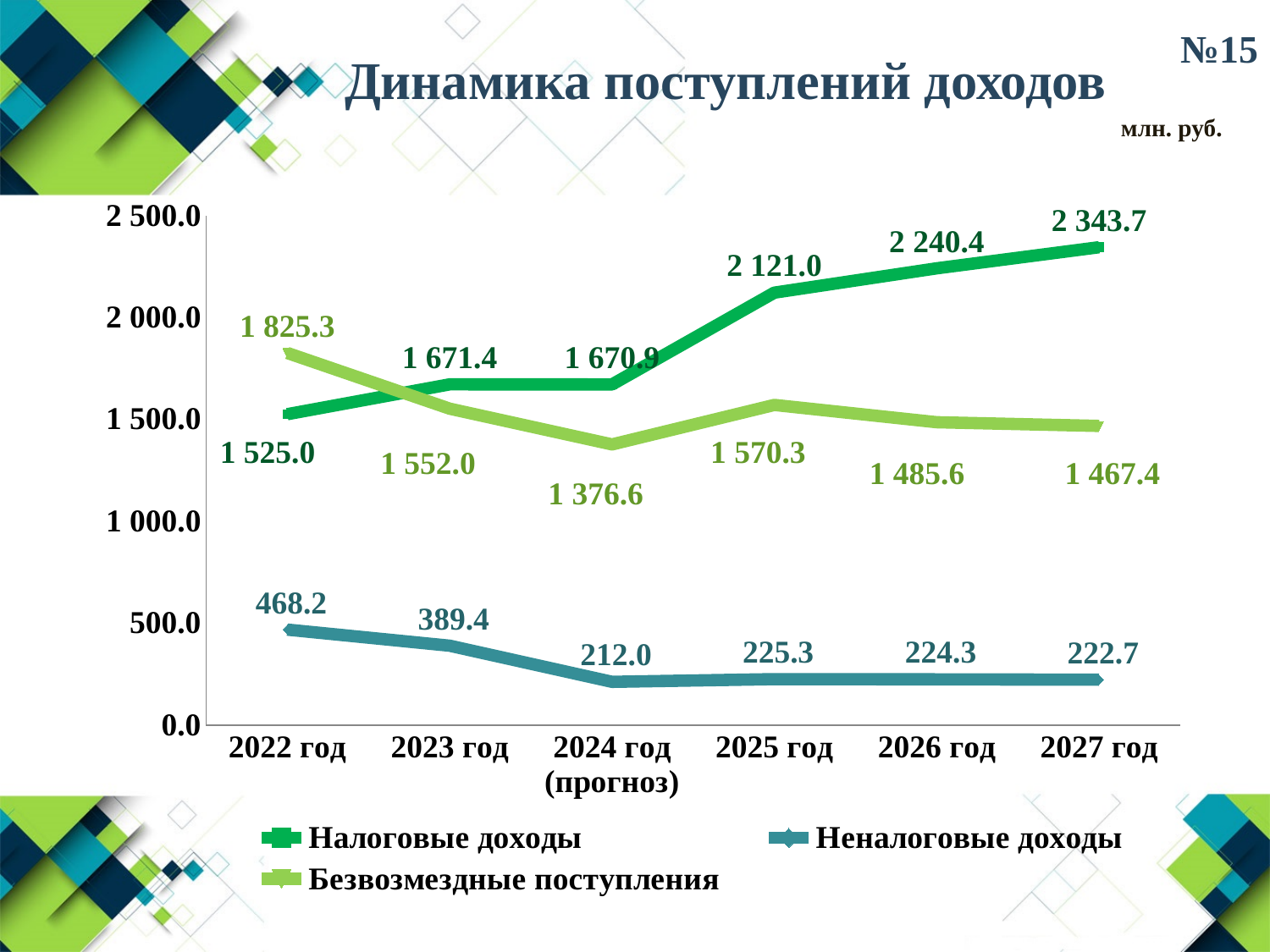
How many years are shown on the x axis? 6 What is the value of Неналоговые доходы for 2024 год (прогноз)? 212.0 How many series does the legend list? 3 What is the difference between Налоговые доходы in 2027 год and 2022 год? 818.7 In which year is Безвозмездные поступления lowest? 2024 год (прогноз) What is the value of Безвозмездные поступления for 2022 год? 1 825.3 In which year is Неналоговые доходы highest? 2022 год Do the values of Налоговые доходы generally rise or fall from 2022 год to 2027 год? Rise What is the value of Налоговые доходы for 2027 год? 2 343.7 Which is larger in 2022 год: Налоговые доходы or Безвозмездные поступления? Безвозмездные поступления What kind of chart is shown on the slide? Line chart What unit is indicated for the chart values? млн. руб.